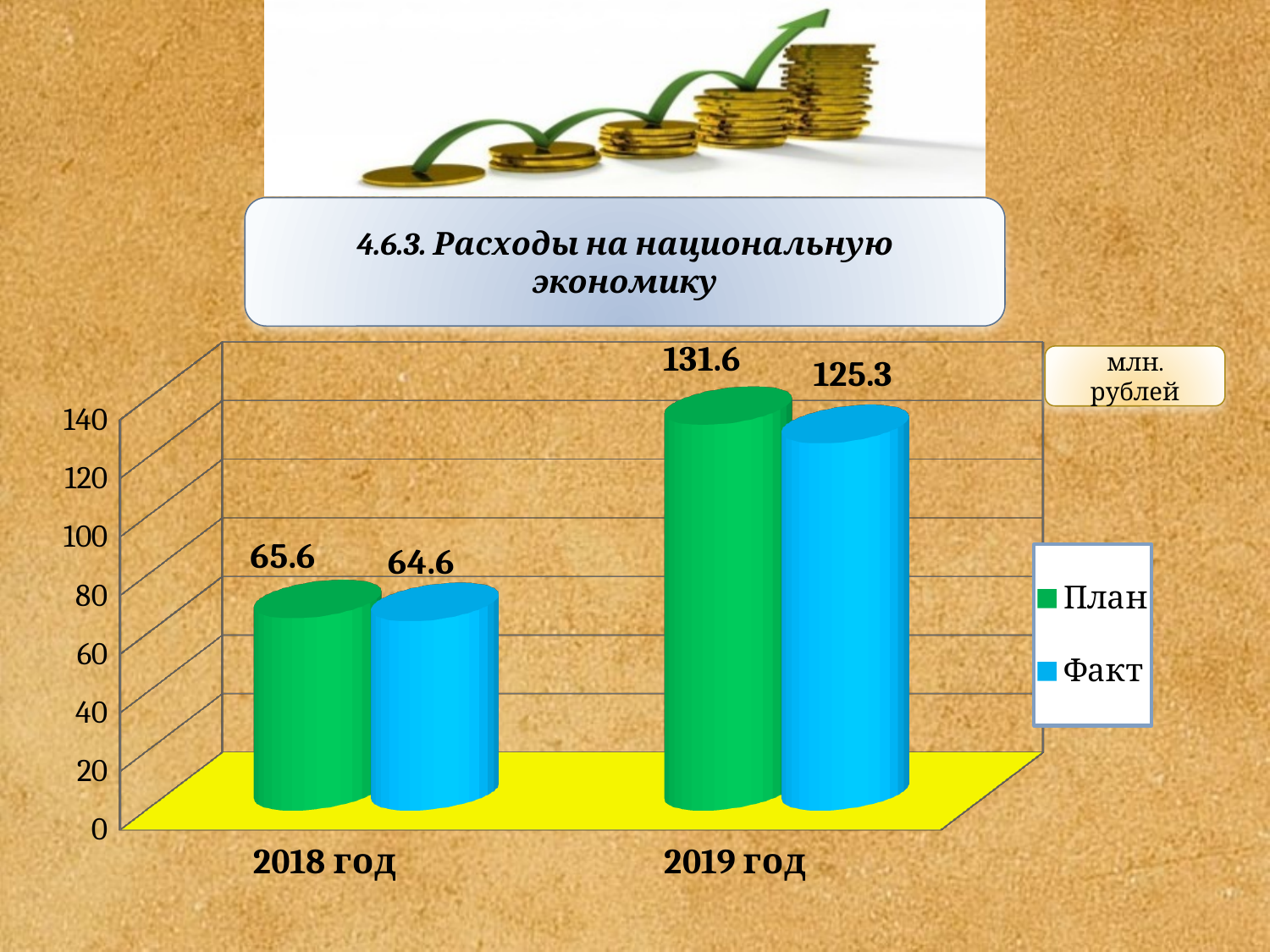
What is the difference between План and Факт for 2019 год? 6.3 What kind of chart is shown on the slide? bar chart Which year has the lowest Факт value? 2018 год What is the difference between the План values for 2019 год and 2018 год? 66 What unit is shown in the box next to the chart? млн. рублей How many series does the legend list? 2 What is the План value for 2019 год? 131.6 What is the План value for 2018 год? 65.6 Which year has the highest План value? 2019 год What is the Факт value for 2018 год? 64.6 Which is larger for 2018 год, План or Факт? План What is the Факт value for 2019 год? 125.3